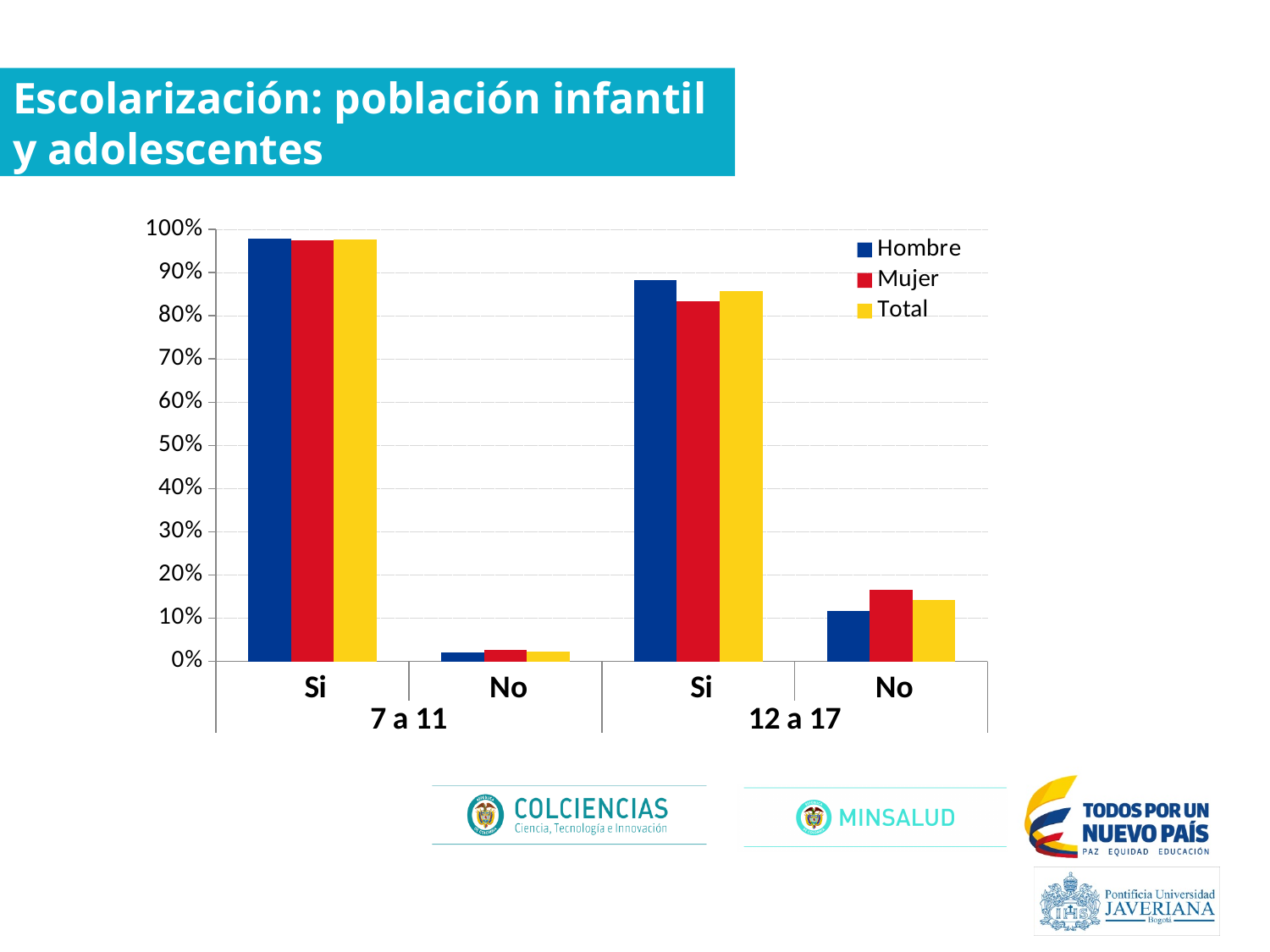
Is the value for Mujer in the 'No' category of the 12 a 17 group greater or less than 20%? less How many series does the legend list? 3 For Hombre in the 'Si' category, which age group has the larger value, 7 a 11 or 12 a 17? 7 a 11 In the 'Si' category of the 12 a 17 group, which is larger, Hombre or Mujer? Hombre How many age groups are shown along the x axis? 2 In the 'No' category of the 12 a 17 group, which series has the highest value? Mujer Is the value for Hombre in the 'No' category of the 7 a 11 group greater or less than 10%? less Is the value for Hombre in the 'Si' category of the 12 a 17 group greater or less than 80%? greater What are the three series named in the legend? Hombre, Mujer, Total What kind of chart is shown on the slide? bar chart In the 'Si' category of the 12 a 17 group, which series has the lowest value? Mujer